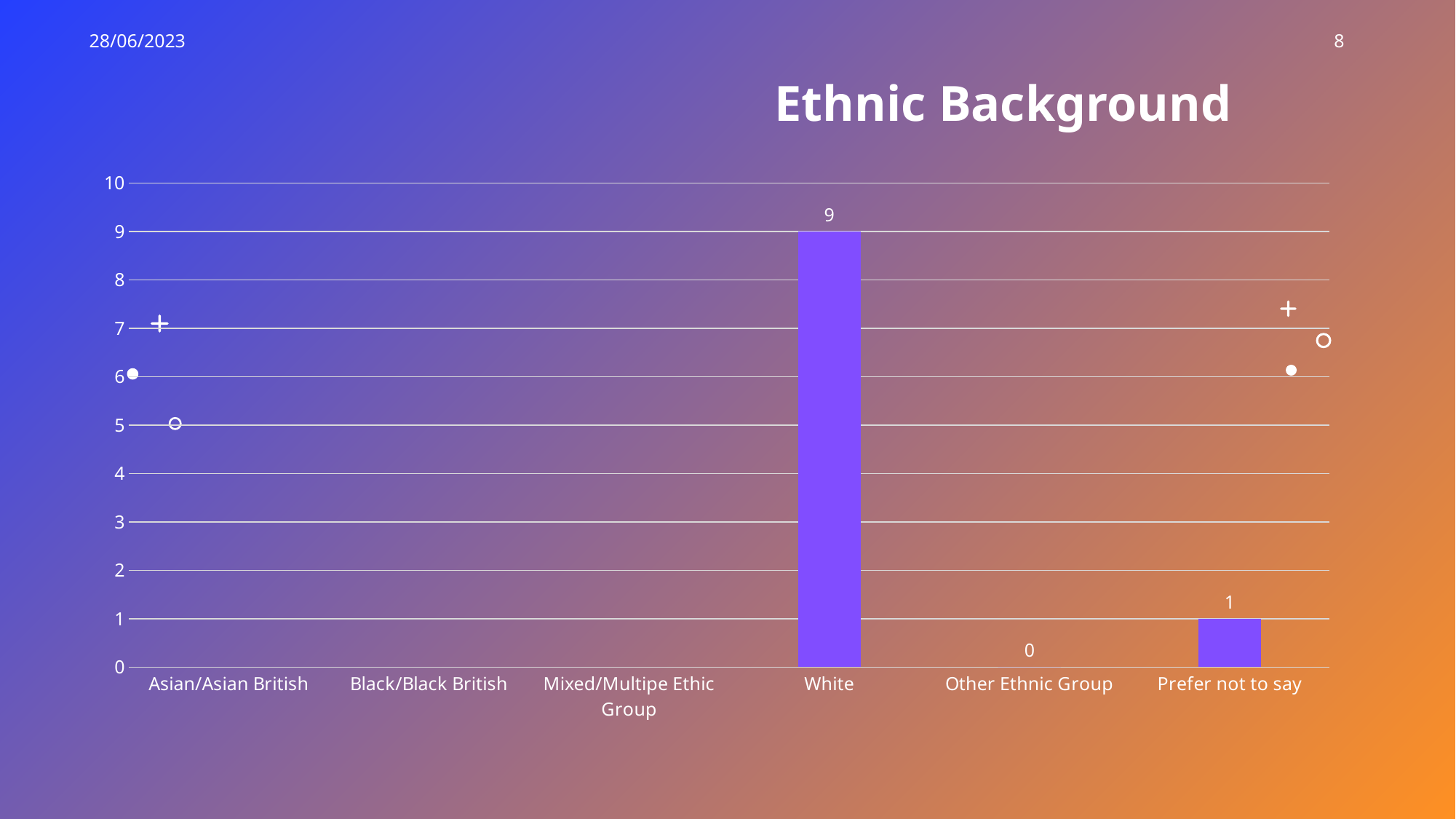
How many categories are shown on the x axis? 6 Which category has the highest value? White What is the value for Other Ethnic Group? 0 What is the value for White? 9 Is the value for White greater or less than 5? greater What is the difference between the values for Prefer not to say and Other Ethnic Group? 1 Which is larger, the value for White or the value for Prefer not to say? White What is the value for Prefer not to say? 1 What is the highest value shown on the y axis? 10 What is the difference between the values for White and Prefer not to say? 8 What kind of chart is shown on the slide? bar chart What is the title of the chart? Ethnic Background